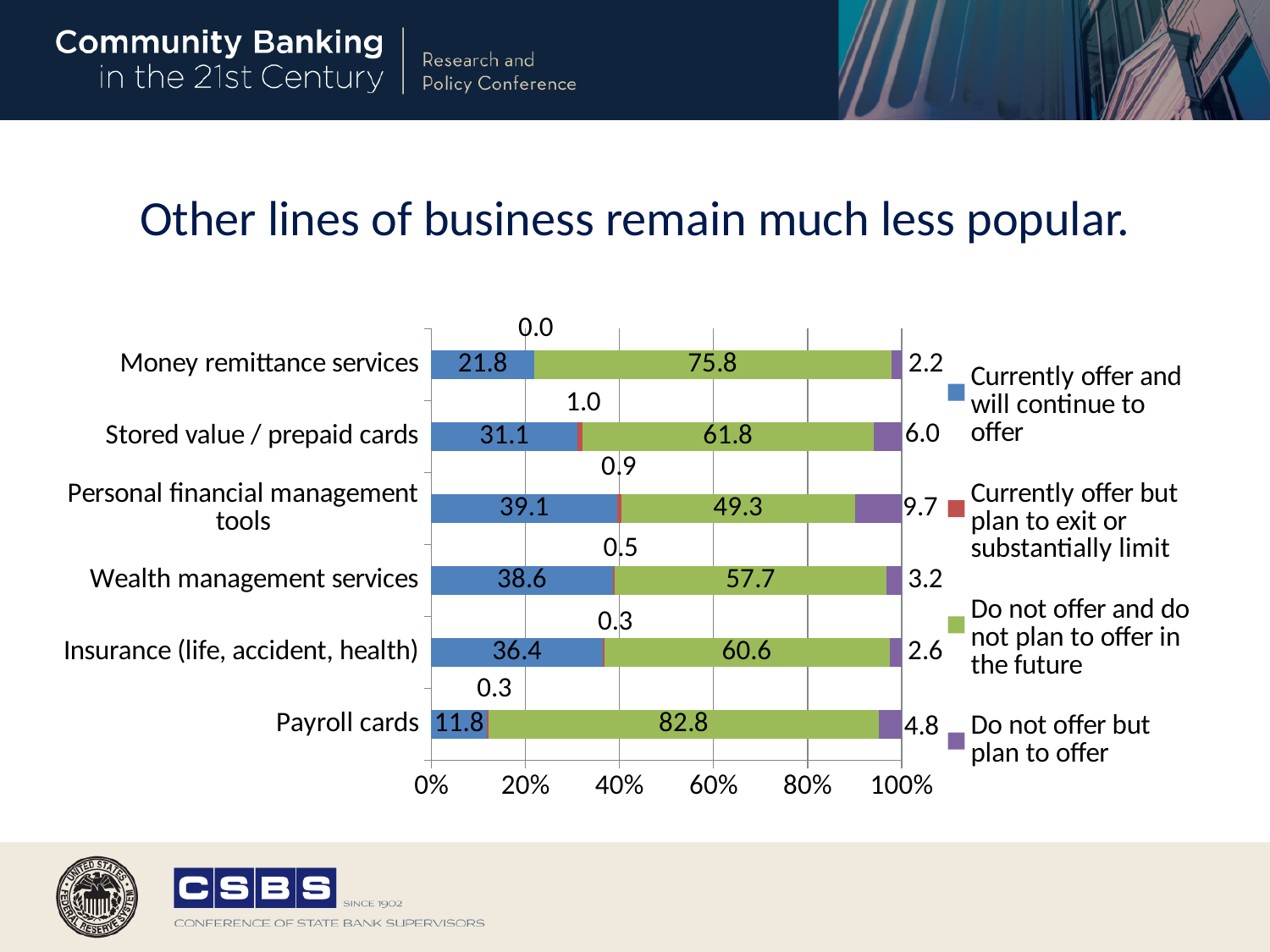
How many lines of business are shown in the chart? 6 Which line of business has the lowest 'Currently offer and will continue to offer' value? Payroll cards What is the 'Currently offer but plan to exit or substantially limit' value for stored value / prepaid cards? 1.0 What kind of chart is shown on the slide? Stacked bar chart Which is larger for wealth management services: the 'Currently offer and will continue to offer' value or the 'Do not offer and do not plan to offer' value? Do not offer and do not plan to offer in the future Which line of business has the highest 'Currently offer and will continue to offer' value? Personal financial management tools What is the 'Do not offer but plan to offer' value for personal financial management tools? 9.7 What is the value for 'Do not offer and do not plan to offer in the future' for payroll cards? 82.8 What is the difference between the 'Do not offer and do not plan to offer' value and the 'Currently offer and will continue to offer' value for payroll cards? 71.0 What percentage of banks currently offer and will continue to offer money remittance services? 21.8 Which line of business has the highest 'Do not offer but plan to offer' value? Personal financial management tools How many series does the legend list? 4